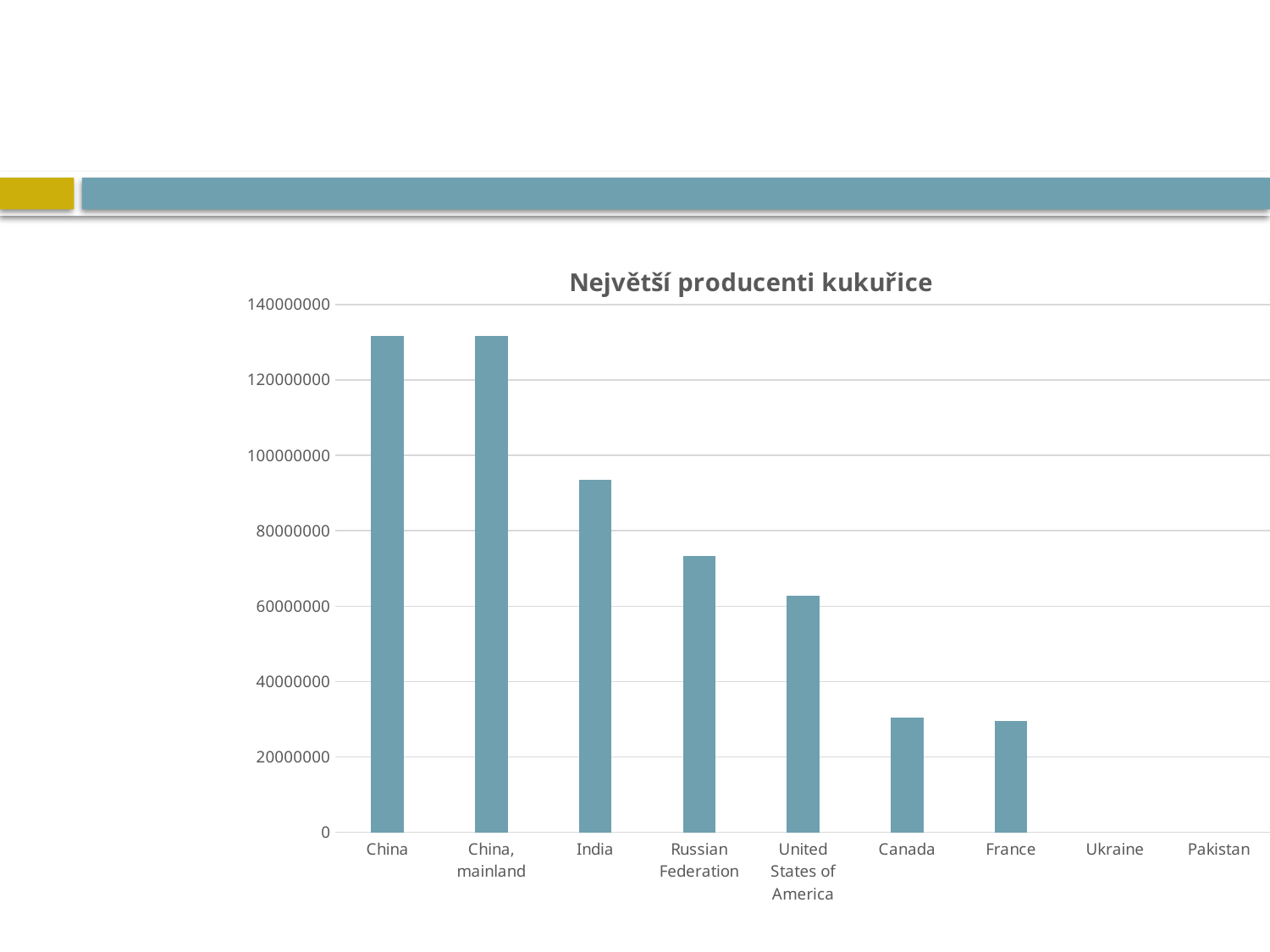
Do the bar values generally rise or fall from left to right along the x axis? fall What kind of chart is shown on the slide? bar chart Which has the larger value, United States of America or Canada? United States of America Is the value for China greater or less than 120000000? greater Is the value for Russian Federation greater or less than 80000000? less How many categories are listed on the x axis of the chart? 9 Is the value for United States of America greater or less than 60000000? greater What is the title of the chart? Největší producenti kukuřice Which has the larger value, India or Russian Federation? India